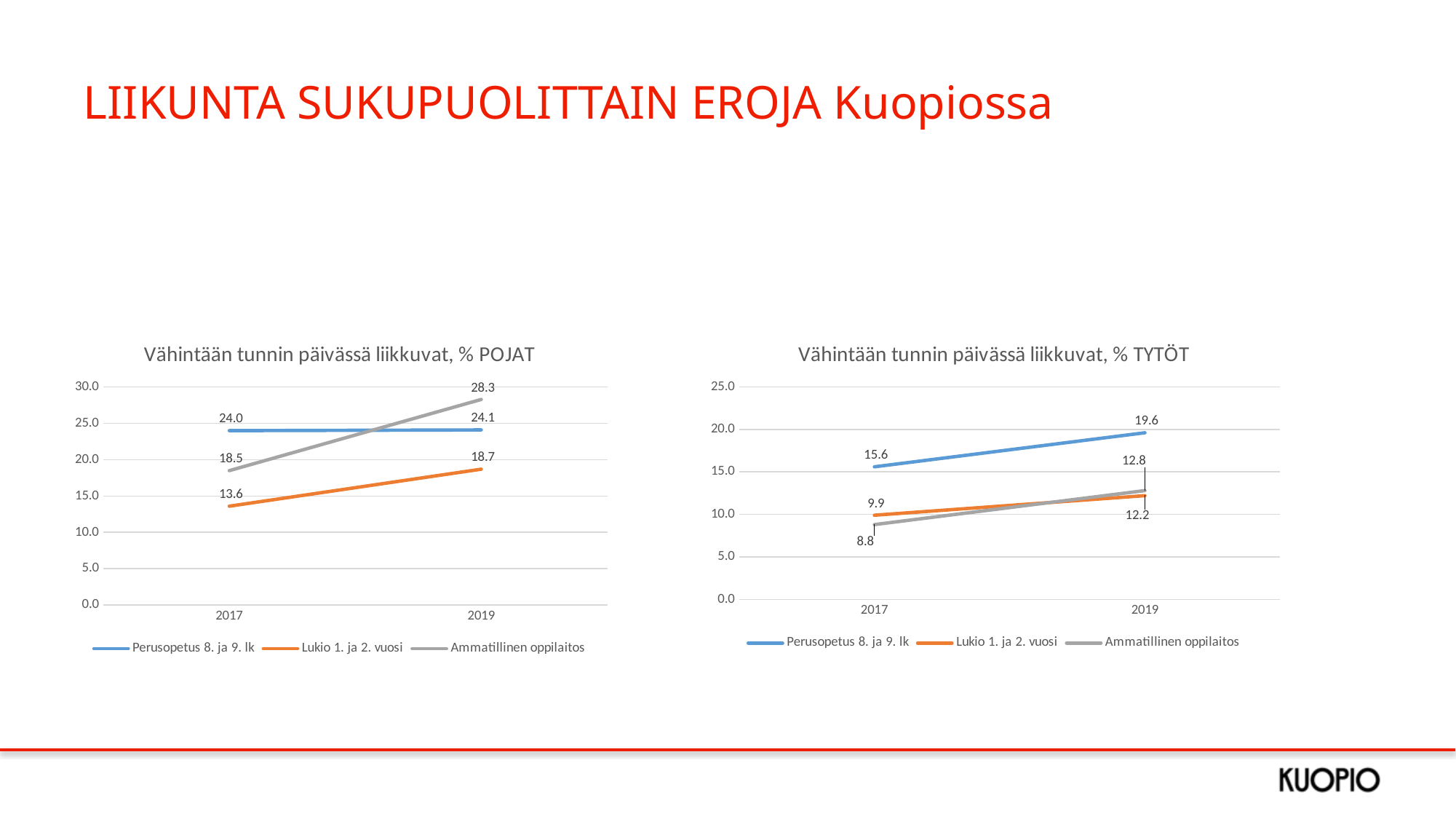
In the chart titled "Vähintään tunnin päivässä liikkuvat, % TYTÖT", which series has the lowest value in 2017? Ammatillinen oppilaitos In the chart titled "Vähintään tunnin päivässä liikkuvat, % POJAT", which is larger in 2017: Perusopetus 8. ja 9. lk or Ammatillinen oppilaitos? Perusopetus 8. ja 9. lk In the chart titled "Vähintään tunnin päivässä liikkuvat, % TYTÖT", what is the value for Perusopetus 8. ja 9. lk in 2019? 19.6 In the chart titled "Vähintään tunnin päivässä liikkuvat, % TYTÖT", what is the value for Ammatillinen oppilaitos in 2017? 8.8 In the chart titled "Vähintään tunnin päivässä liikkuvat, % POJAT", what is the value for Lukio 1. ja 2. vuosi in 2017? 13.6 In the chart titled "Vähintään tunnin päivässä liikkuvat, % POJAT", what is the value for Ammatillinen oppilaitos in 2019? 28.3 How many series does the legend of the chart titled "Vähintään tunnin päivässä liikkuvat, % POJAT" list? 3 In the chart titled "Vähintään tunnin päivässä liikkuvat, % POJAT", by how much did the value for Ammatillinen oppilaitos change from 2017 to 2019? 9.8 In the chart titled "Vähintään tunnin päivässä liikkuvat, % POJAT", which series has the highest value in 2019? Ammatillinen oppilaitos In the chart titled "Vähintään tunnin päivässä liikkuvat, % TYTÖT", does the value for Lukio 1. ja 2. vuosi rise or fall from 2017 to 2019? rise In the chart titled "Vähintään tunnin päivässä liikkuvat, % TYTÖT", what is the difference between Perusopetus 8. ja 9. lk and Lukio 1. ja 2. vuosi in 2019? 7.4 What kind of chart is the chart titled "Vähintään tunnin päivässä liikkuvat, % TYTÖT"? line chart